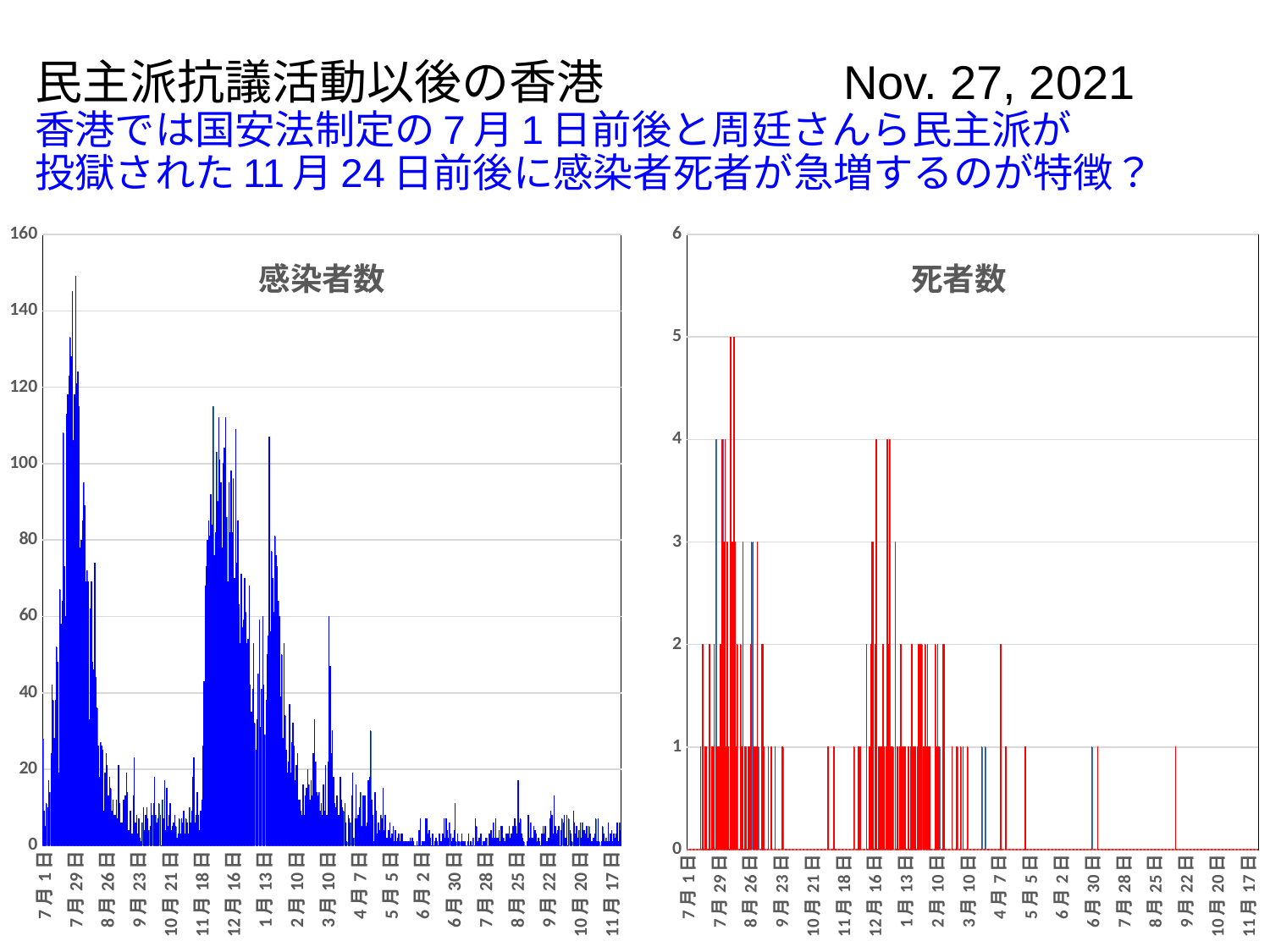
What colour are the bars in the 感染者数 chart? blue On the 死者数 chart, are the values after 5月5日 greater or less than 2? less On the 感染者数 chart, are the values around 11月17日 greater or less than 20? less What kind of chart is the 感染者数 chart on the left? bar chart On the 感染者数 chart, is the highest peak near 7月29日 greater or less than 140? greater What kind of chart is the 死者数 chart on the right? bar chart On the 感染者数 chart, which peak is higher: the one near 7月29日 or the one near 12月16日? the one near 7月29日 On the 感染者数 chart, do the values generally rise or fall from 1月13日 to 11月17日? fall What is the highest daily value reached on the 死者数 chart? 5 On the 死者数 chart, which is higher: the tallest bar near 7月29日 or the tallest bar near 12月16日? the tallest bar near 7月29日 What is the title of the chart on the right? 死者数